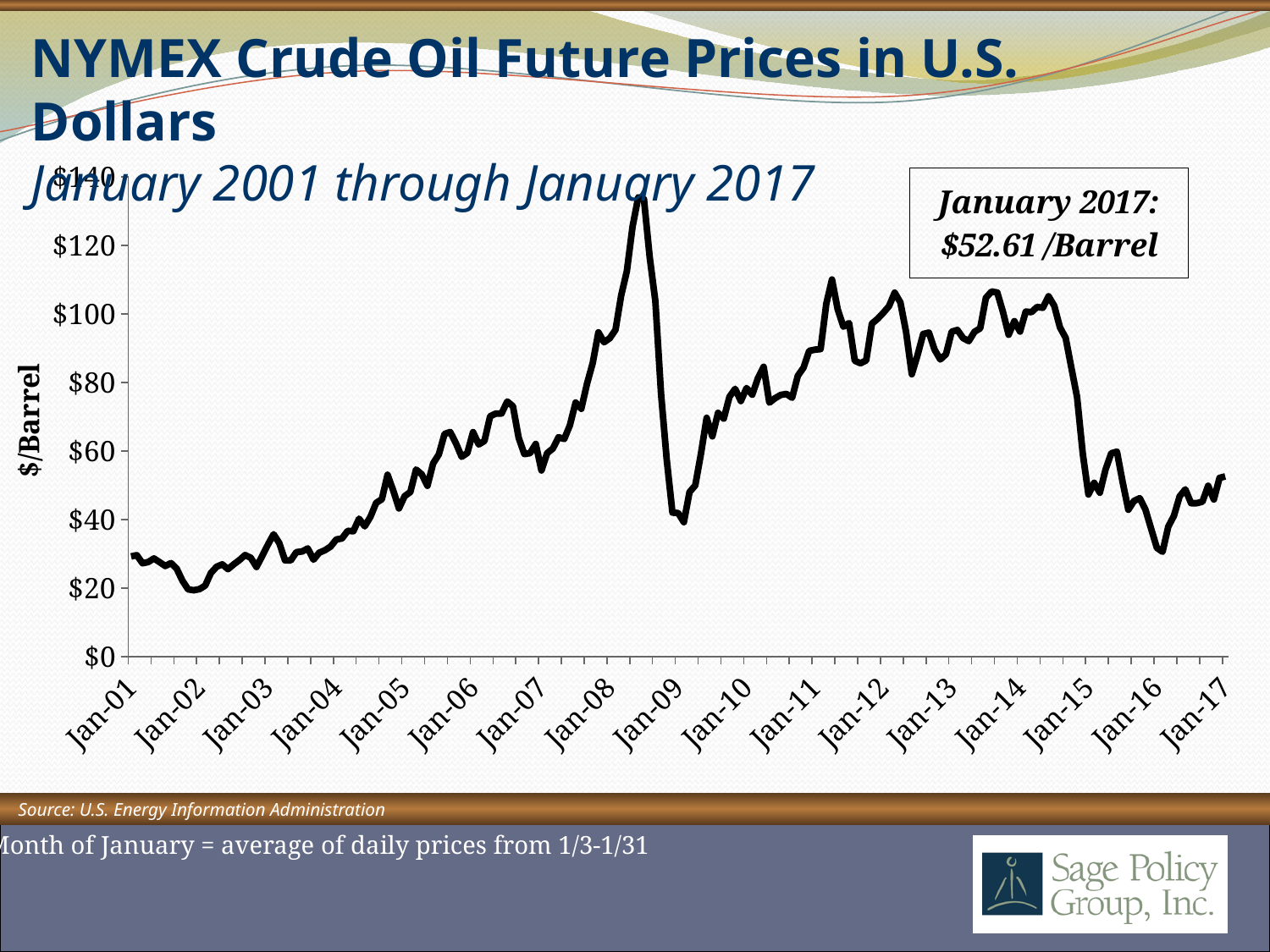
Is the value at Jan-16 greater or less than $40? less What is the label on the y axis? $/Barrel Between Jan-14 and Jan-16, does the line rise or fall? fall What kind of chart is shown on the slide? line chart What source is cited for the chart? U.S. Energy Information Administration In which year does the line reach its highest point? 2008 Is the value at Jan-08 greater or less than $80? greater How many year labels are shown on the x axis? 17 Is the value at Jan-09 greater or less than $60? less Which is larger, the value at Jan-08 or the value at Jan-16? Jan-08 What is the price per barrel for January 2017 according to the callout box? $52.61